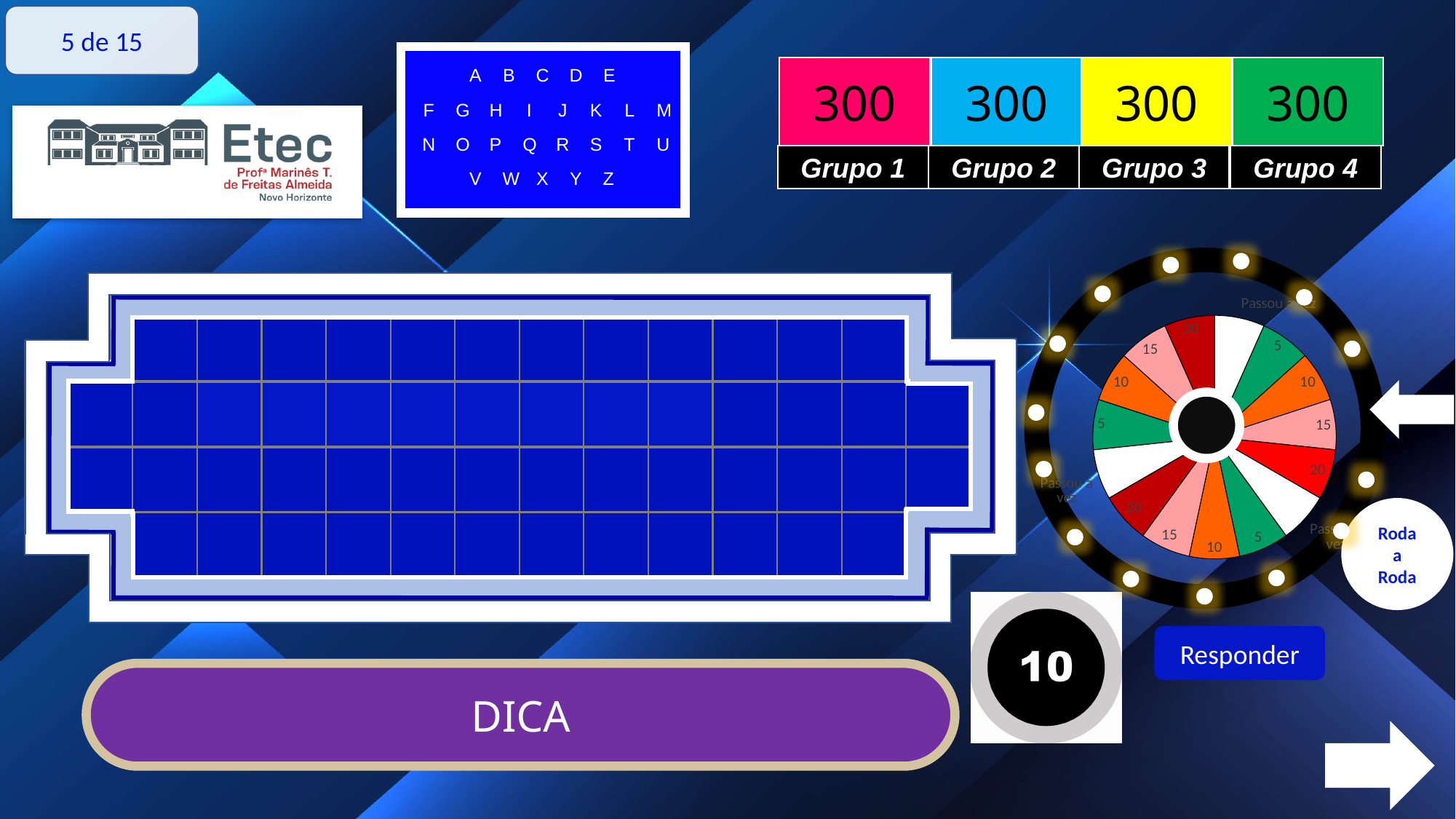
On the wheel on the right, how many slices are labelled 10? 3 On the wheel on the right, how many slices are labelled 15? 3 On the wheel on the right, which is the smallest number printed on any slice? 5 On the wheel on the right, what number is printed on the green slices? 5 On the wheel on the right, which is the largest number printed on any slice? 20 On the wheel on the right, how many slices are labelled 20? 3 What kind of chart is the wheel on the right side of the slide? pie chart On the wheel on the right, what number is printed on the red slices? 20